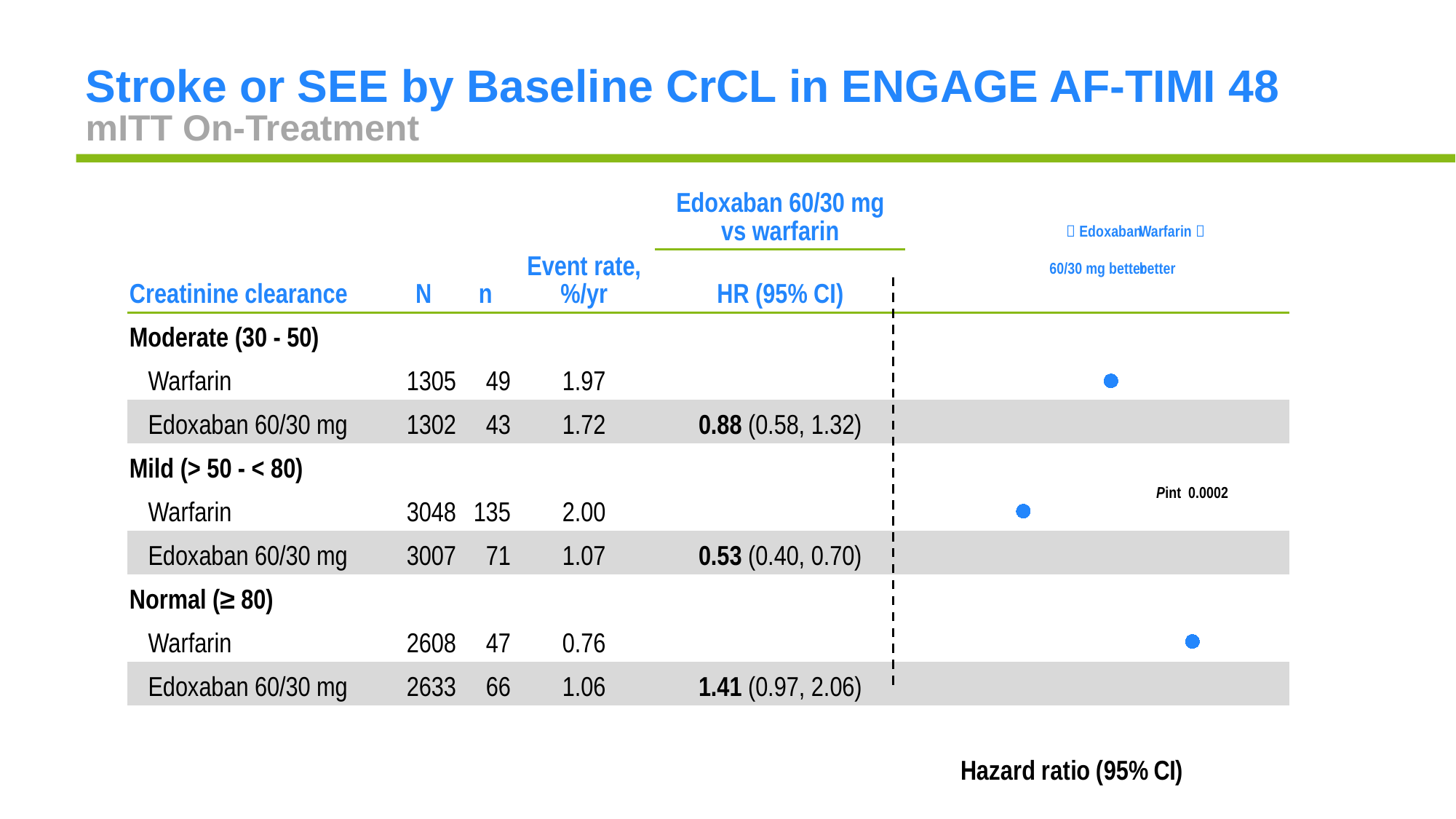
What is the hazard ratio for edoxaban vs warfarin in the Mild (> 50 - < 80) creatinine clearance group? 0.53 How many data points are plotted in the forest plot? 3 What is the x-axis label of the forest plot? Hazard ratio (95% CI) What is the 95% CI for the hazard ratio in the Mild (> 50 - < 80) group? (0.40, 0.70) Which creatinine clearance group has the lowest hazard ratio? Mild (> 50 - < 80) Which creatinine clearance group has the highest hazard ratio? Normal (≥ 80) What kind of chart is shown to the right of the table? Forest plot Is the hazard ratio for the Normal (≥ 80) group greater or less than 1? greater Which has the larger hazard ratio, the Moderate (30 - 50) group or the Mild (> 50 - < 80) group? Moderate (30 - 50) What is the difference between the hazard ratios of the Normal (≥ 80) group and the Moderate (30 - 50) group? 0.53 What is the hazard ratio for edoxaban vs warfarin in the Normal (≥ 80) creatinine clearance group? 1.41 What is the hazard ratio for edoxaban vs warfarin in the Moderate (30 - 50) creatinine clearance group? 0.88